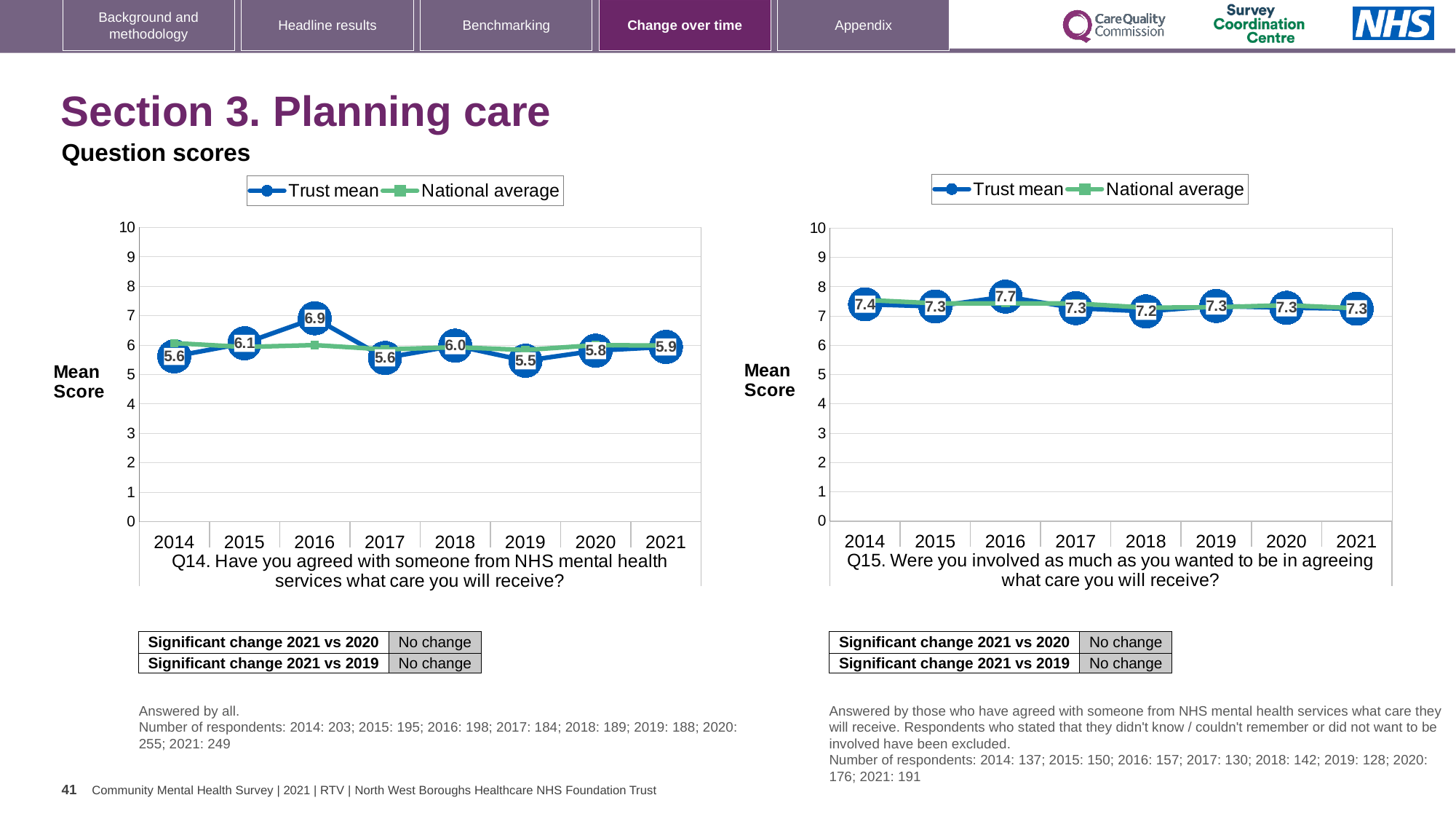
In the Q15 chart on the right, which year has the highest Trust mean? 2016 In the Q14 chart on the left, which year has the highest Trust mean? 2016 In the Q14 chart on the left, what is the difference between the Trust mean in 2016 and in 2017? 1.3 What kind of chart is the Q14 chart on the left? Line chart In the Q14 chart on the left, how many years are plotted on the x axis? 8 In the Q14 chart on the left, what is the Trust mean for 2016? 6.9 How many series does the legend of the Q15 chart on the right list? 2 In the Q14 chart on the left, which year has the lowest Trust mean? 2019 In the Q14 chart on the left, what is the Trust mean for 2021? 5.9 In the Q15 chart on the right, what is the Trust mean for 2018? 7.2 In the Q15 chart on the right, is the Trust mean for 2016 greater or less than 7? greater In the Q15 chart on the right, is the Trust mean for 2014 larger or smaller than the Trust mean for 2018? larger